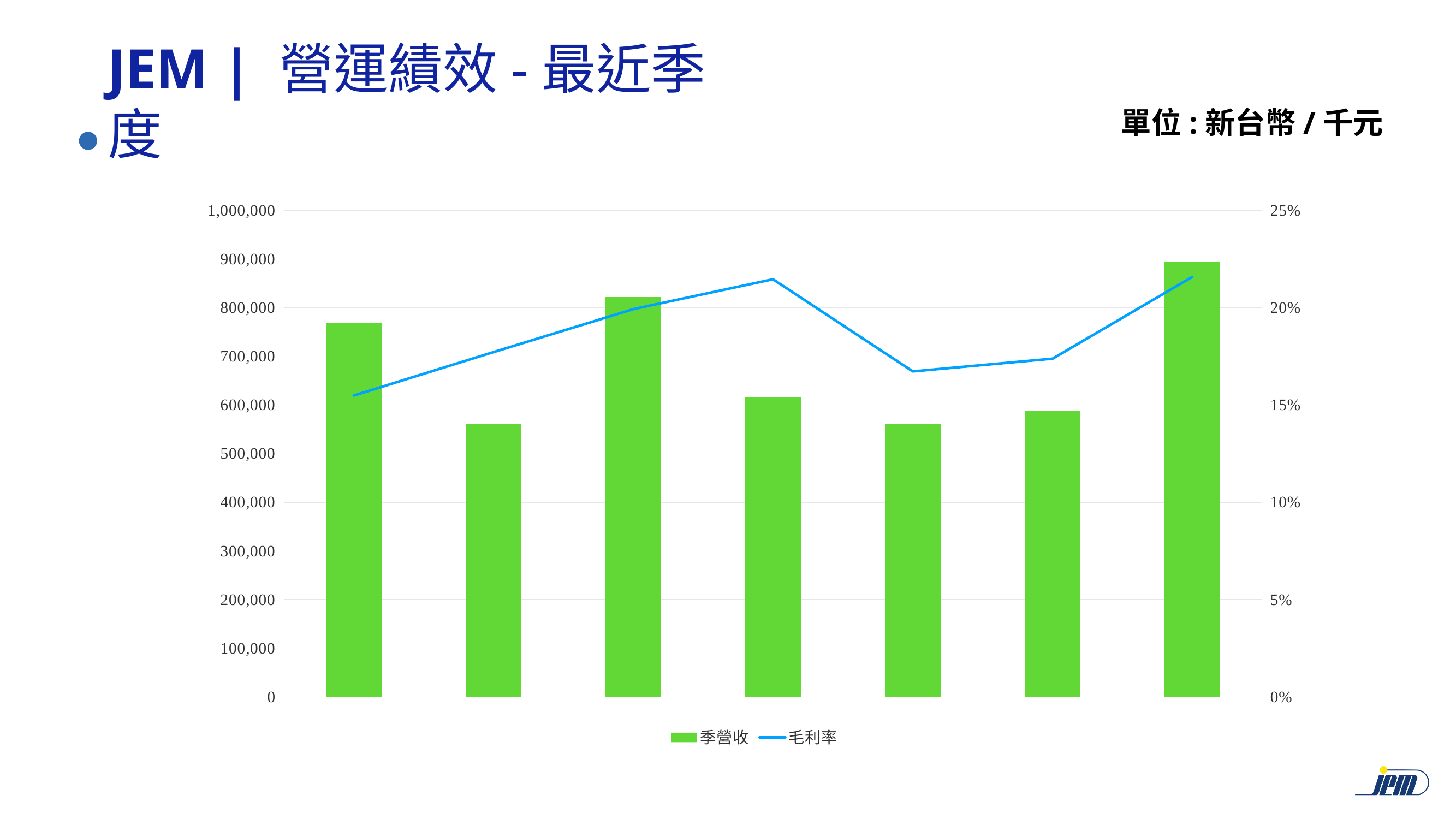
What are the two series named in the legend? 季營收 and 毛利率 Which point on the 毛利率 line is the lowest? The first point How many series does the legend list? 2 Is the value of the third bar greater or less than 800,000? greater Is the 毛利率 value at the fourth point greater or less than 20%? greater What kind of chart is shown on the slide? A combined bar and line chart Which is larger, the first bar or the second bar? The first bar Is the value of the first bar greater or less than 700,000? greater Which bar is the highest in the chart? The seventh (last) bar How many bars are plotted in the chart? 7